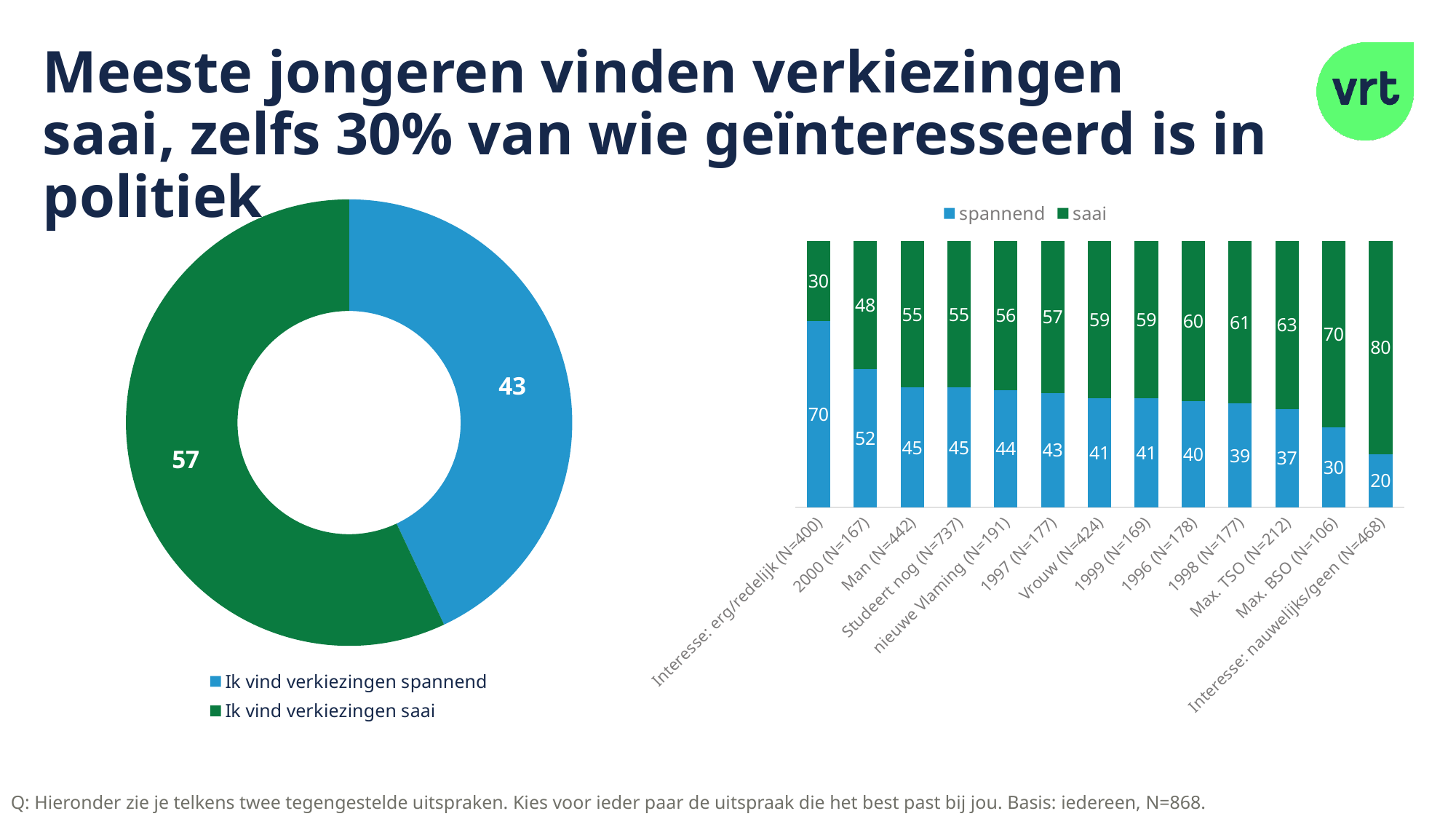
In the stacked bar chart on the right, which category has the lowest 'spannend' value? Interesse: nauwelijks/geen (N=468) In the stacked bar chart on the right, what is the difference between the 'spannend' values for 'Interesse: erg/redelijk (N=400)' and 'Interesse: nauwelijks/geen (N=468)'? 50 In the stacked bar chart on the right, what is the total of the stacked bar for '2000 (N=167)'? 100 In the stacked bar chart on the right, what is the 'saai' value for 'Vrouw (N=424)'? 59 In the donut chart on the left, what value is shown for 'Ik vind verkiezingen saai'? 57 What kind of chart is shown on the left of the slide? Donut (pie) chart In the stacked bar chart on the right, how many categories are shown on the x axis? 13 In the donut chart on the left, which segment is larger: 'Ik vind verkiezingen spannend' or 'Ik vind verkiezingen saai'? Ik vind verkiezingen saai In the stacked bar chart on the right, how many series does the legend list? 2 In the stacked bar chart on the right, which colour represents the 'saai' series? Green In the stacked bar chart on the right, which category has the highest 'saai' value? Interesse: nauwelijks/geen (N=468) In the stacked bar chart on the right, what is the 'spannend' value for 'Max. BSO (N=106)'? 30